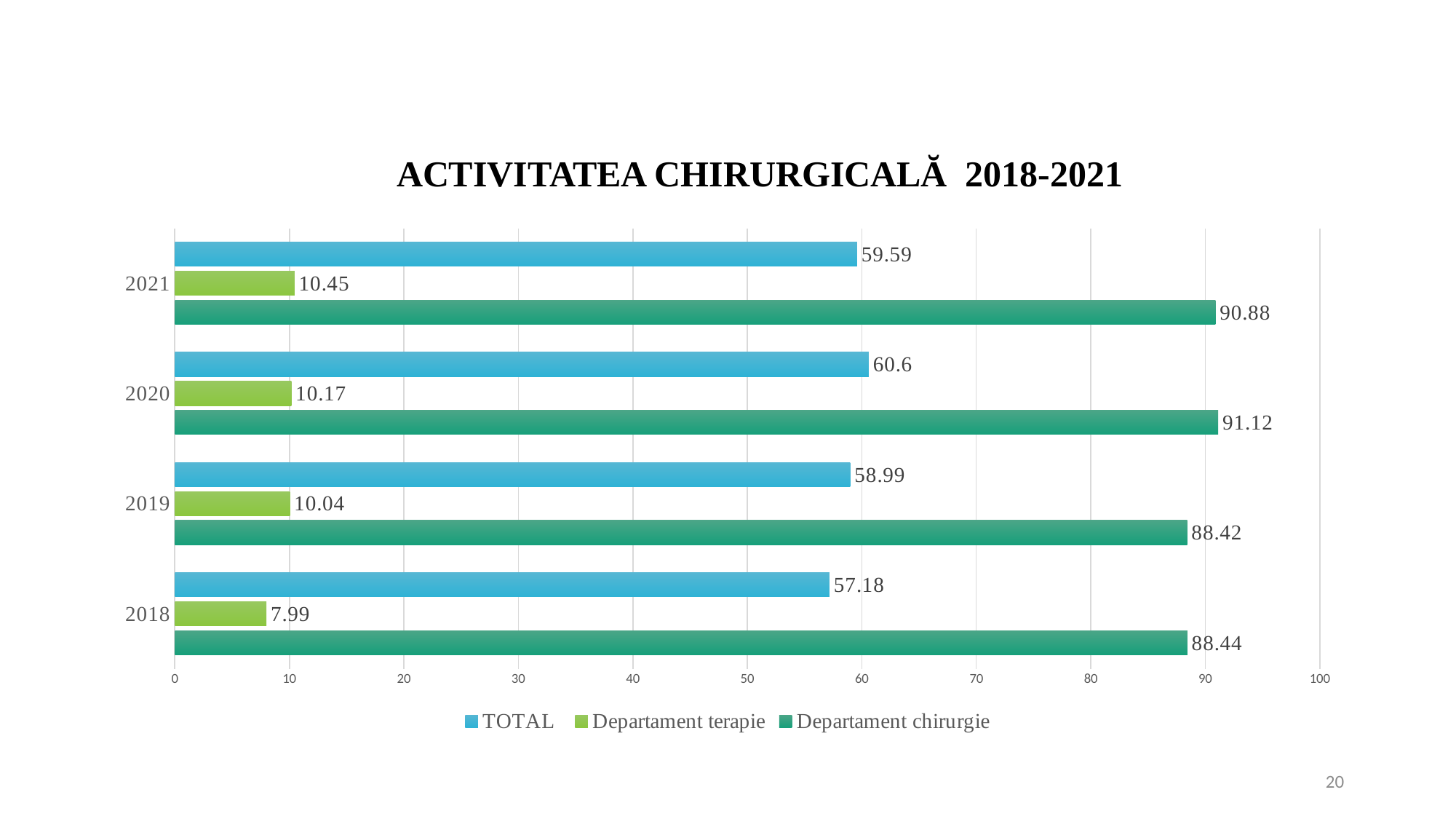
How many years are shown on the chart? 4 What is the TOTAL value for 2018? 57.18 Which is larger: the TOTAL value for 2019 or the TOTAL value for 2021? 2021 What kind of chart is shown on the slide? Bar chart What is the value for Departament chirurgie in 2020? 91.12 What is the value for Departament terapie in 2021? 10.45 Which year has the highest TOTAL value? 2020 What is the title of the chart? ACTIVITATEA CHIRURGICALĂ 2018-2021 What is the difference between the Departament chirurgie values for 2020 and 2021? 0.24 How many series does the legend list? 3 Is the value for Departament chirurgie in 2019 greater or less than 80? greater Which year has the lowest value for Departament terapie? 2018